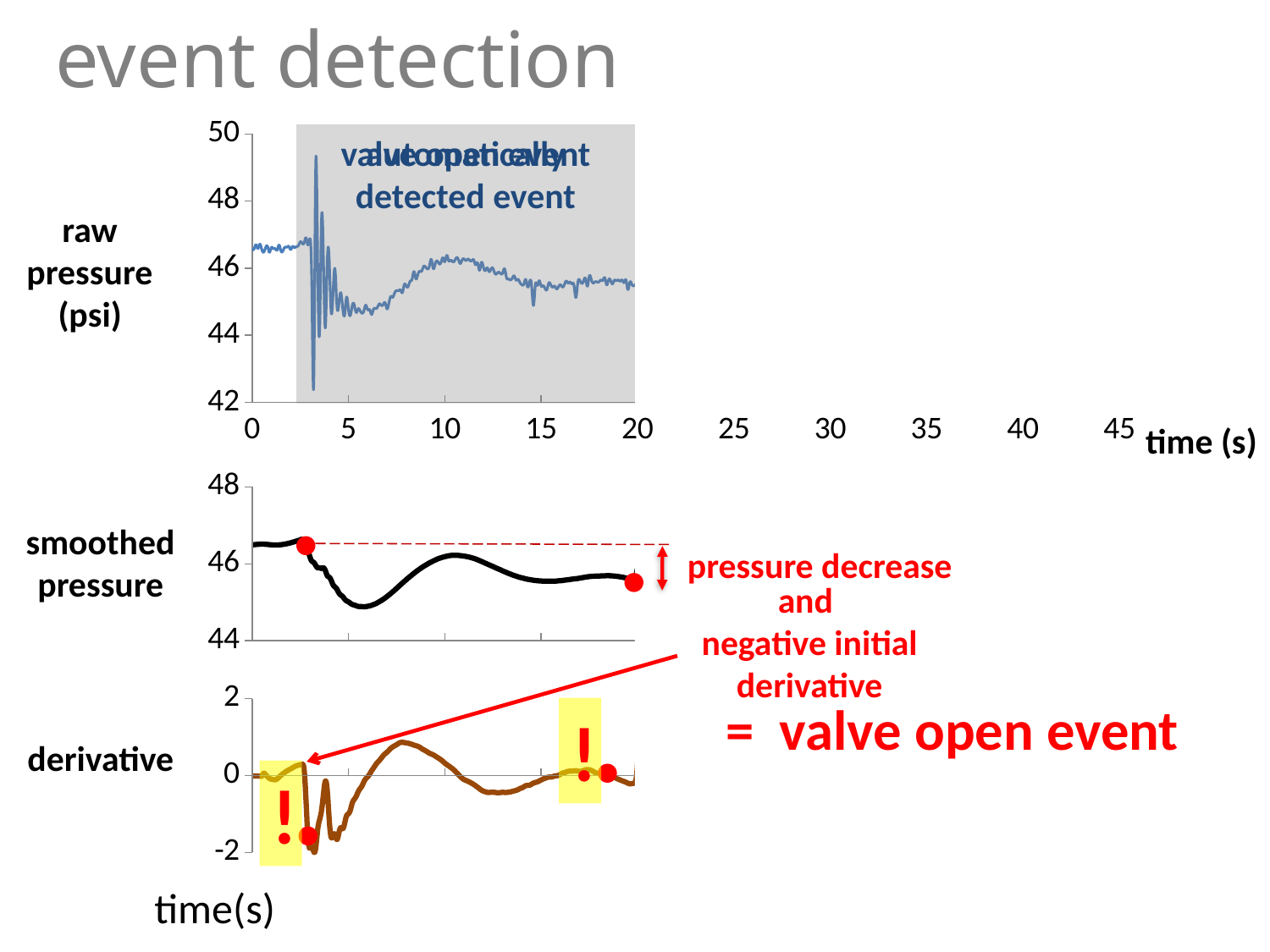
In the raw pressure chart, is the pressure at time 0 greater or less than 46? greater In the smoothed pressure chart, does the pressure rise or fall between the first red dot and the second red dot? fall In the smoothed pressure chart, is the value at the first red dot greater or less than 46? greater How many charts are shown on the slide? 3 In the raw pressure chart, is the lowest point of the spike near 3 seconds greater or less than 44? less What kind of chart is the raw pressure chart at the top of the slide? line chart What is the unit shown for the raw pressure axis label? psi What kind of chart is the derivative chart at the bottom of the slide? line chart